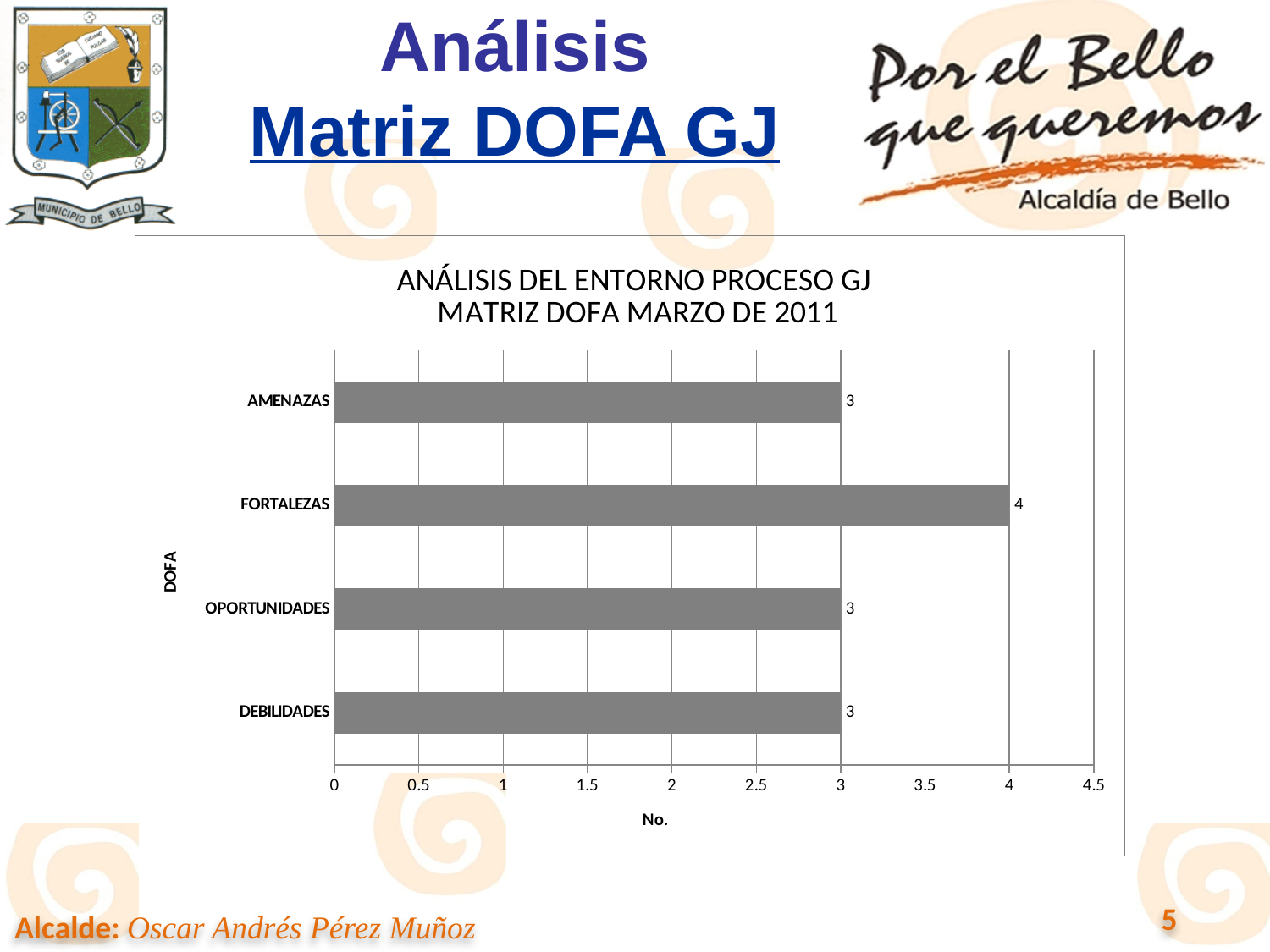
Which category has the highest value? FORTALEZAS What is the total of the values for all four categories? 13 What is the value for AMENAZAS? 3 Is the value for FORTALEZAS greater or less than 3.5? greater What kind of chart is shown on the slide? bar chart How many categories are shown on the chart? 4 What is the title of the chart? ANÁLISIS DEL ENTORNO PROCESO GJ MATRIZ DOFA MARZO DE 2011 What is the label of the horizontal axis? No. What is the value for DEBILIDADES? 3 What is the difference between the values for FORTALEZAS and OPORTUNIDADES? 1 Which is larger, the value for FORTALEZAS or the value for DEBILIDADES? FORTALEZAS What is the value for FORTALEZAS? 4